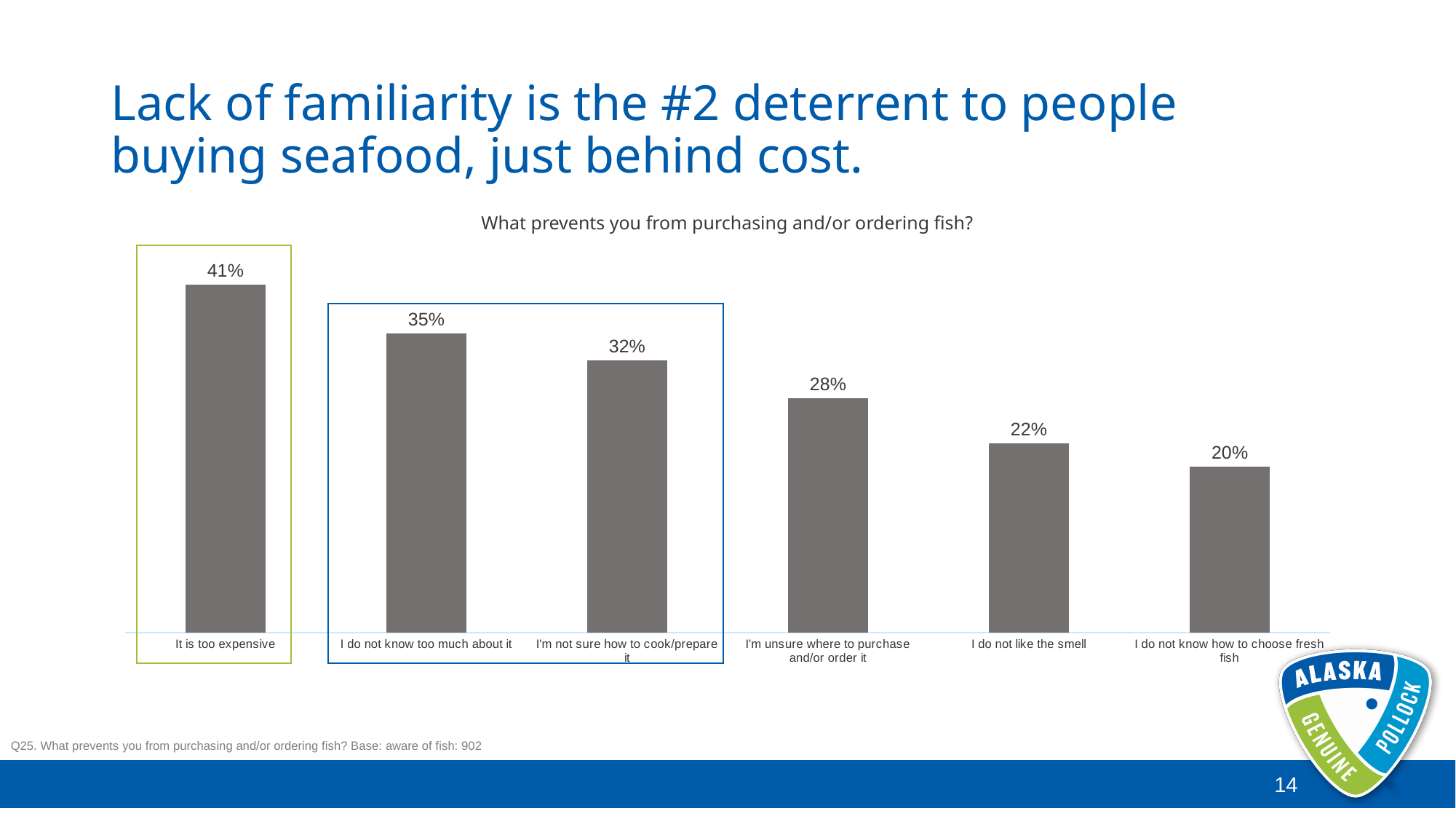
What kind of chart is shown on the slide? Bar chart What percentage of respondents said "It is too expensive" prevents them from purchasing or ordering fish? 41% What is the value for "I do not like the smell"? 22% How many categories are shown in the chart? 6 What is the difference between "I'm unsure where to purchase and/or order it" and "I do not know how to choose fresh fish"? 8 percentage points What is the title of the chart? What prevents you from purchasing and/or ordering fish? Which is larger: the value for "I do not know too much about it" or the value for "I'm unsure where to purchase and/or order it"? I do not know too much about it Which category has the highest value in the chart? It is too expensive Do the values rise or fall from left to right across the categories? Fall What is the value for "I'm not sure how to cook/prepare it"? 32% Which category has the lowest value in the chart? I do not know how to choose fresh fish What is the difference between "It is too expensive" and "I do not know too much about it"? 6 percentage points